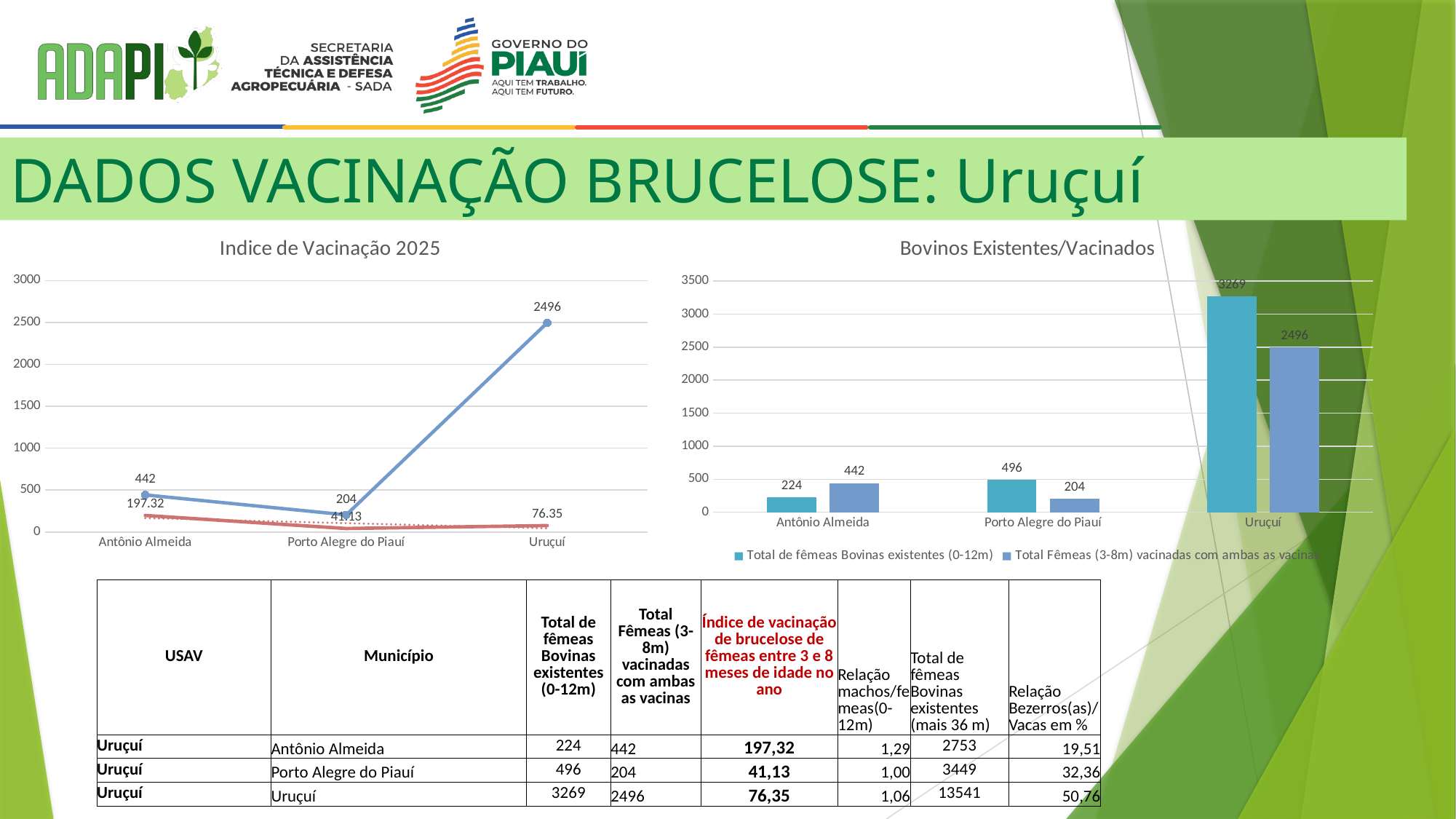
In the 'Bovinos Existentes/Vacinados' chart, which municipality has the highest value for 'Total de fêmeas Bovinas existentes (0-12m)'? Uruçuí What kind of chart is 'Indice de Vacinação 2025'? Line chart What kind of chart is 'Bovinos Existentes/Vacinados'? Bar chart In the 'Indice de Vacinação 2025' chart, what is the value of the blue line for Uruçuí? 2496 In the 'Bovinos Existentes/Vacinados' chart, for Antônio Almeida, which is larger: 'Total de fêmeas Bovinas existentes (0-12m)' or 'Total Fêmeas (3-8m) vacinadas com ambas as vacinas'? Total Fêmeas (3-8m) vacinadas com ambas as vacinas In the 'Bovinos Existentes/Vacinados' chart, what is the difference between the two bars for Uruçuí? 773 How many municipalities are shown on the x axis of the 'Indice de Vacinação 2025' chart? 3 In the 'Bovinos Existentes/Vacinados' chart, what is the value of 'Total de fêmeas Bovinas existentes (0-12m)' for Uruçuí? 3269 In the 'Bovinos Existentes/Vacinados' chart, which municipality has the lowest value for 'Total Fêmeas (3-8m) vacinadas com ambas as vacinas'? Porto Alegre do Piauí How many series does the legend of the 'Bovinos Existentes/Vacinados' chart list? 2 In the 'Indice de Vacinação 2025' chart, what is the value of the red line for Porto Alegre do Piauí? 41.13 In the 'Bovinos Existentes/Vacinados' chart, what is the value of 'Total Fêmeas (3-8m) vacinadas com ambas as vacinas' for Porto Alegre do Piauí? 204